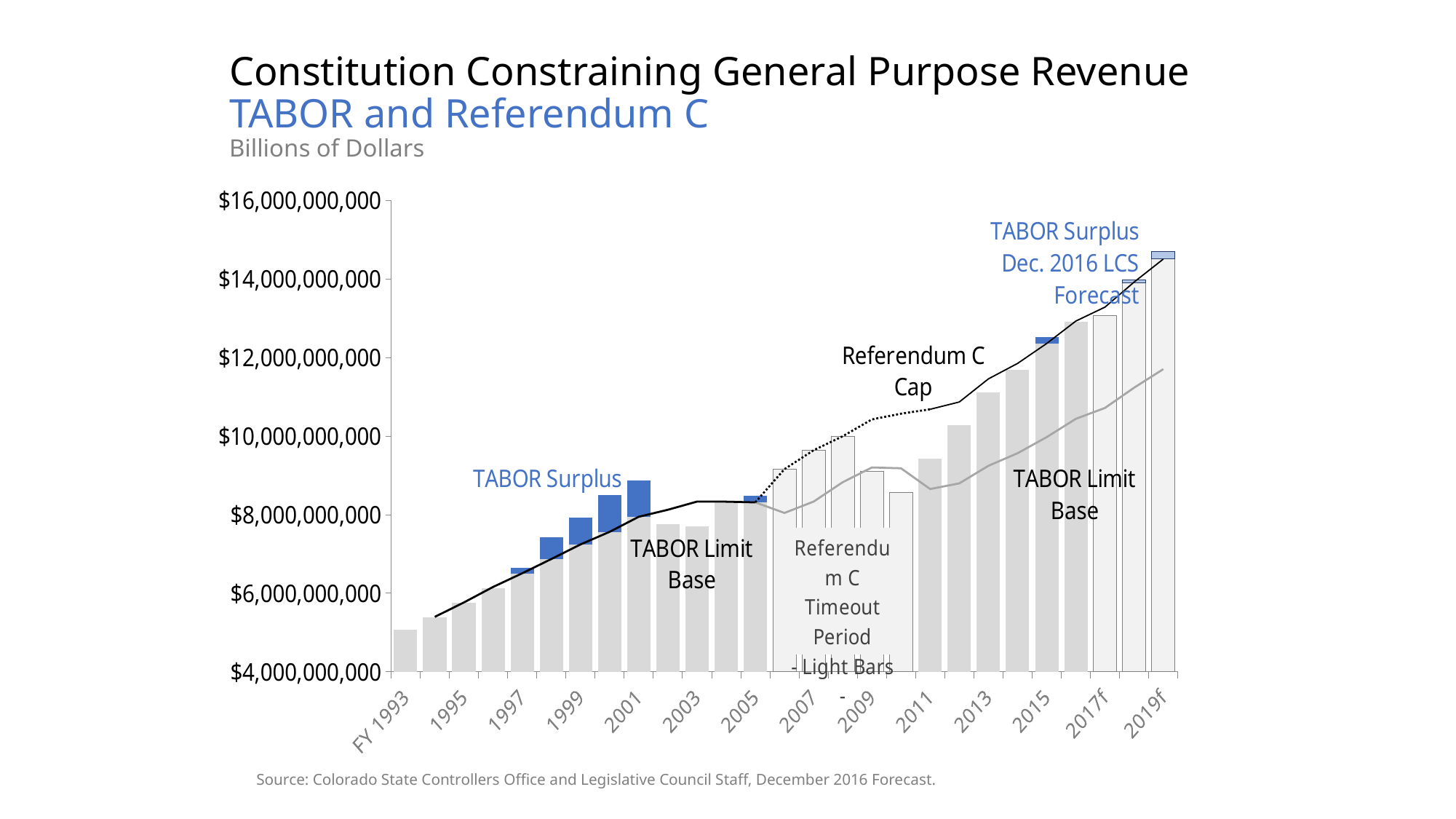
Do the bar values generally rise or fall from FY 1993 to 2019f? rise Is the value for 2013 greater or less than $10,000,000,000? greater Is the value for 2009 greater or less than $10,000,000,000? less What unit is stated below the chart subtitle? Billions of Dollars Is the value for 2015 greater or less than $12,000,000,000? greater Which is larger, the bar for 2013 or the bar for 2009? 2013 Which fiscal year has the highest bar on the chart? 2019f What kind of chart is shown on the slide? combination bar and line chart What label is attached to the dotted line segment on the chart? Referendum C Cap Which fiscal year has the lowest bar on the chart? FY 1993